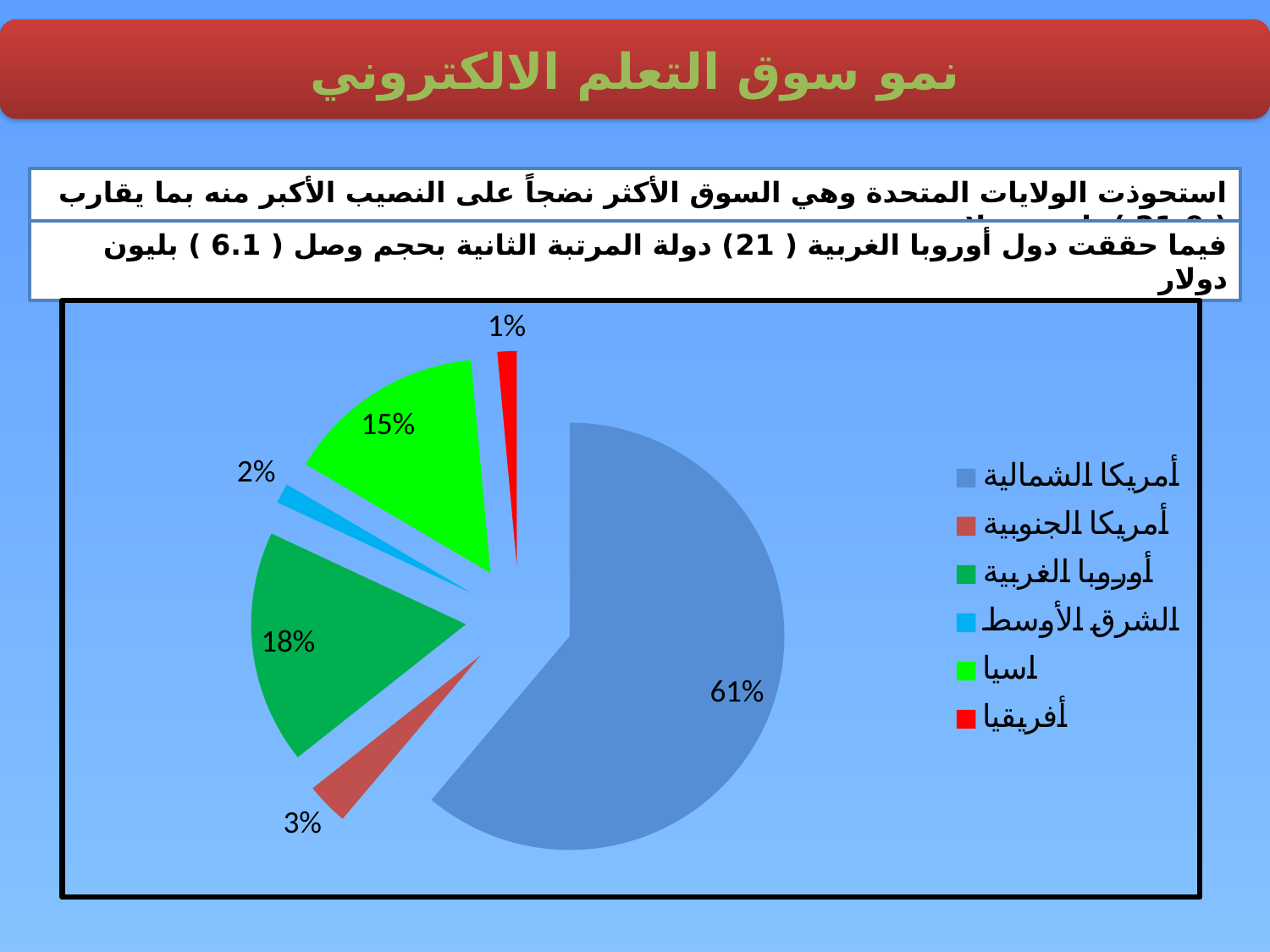
What share of the pie does أمريكا الجنوبية have? 3% Which is larger, the slice for أمريكا الجنوبية or the slice for الشرق الأوسط? أمريكا الجنوبية What is the difference in percentage points between أوروبا الغربية and اسيا? 3 What share of the pie does أمريكا الشمالية have? 61% What share of the pie does الشرق الأوسط have? 2% Which category has the smallest slice of the pie? أفريقيا How many categories does the legend list? 6 Which category has the largest slice of the pie? أمريكا الشمالية What colour is the slice for أفريقيا? Red What kind of chart is shown on the slide? Pie chart